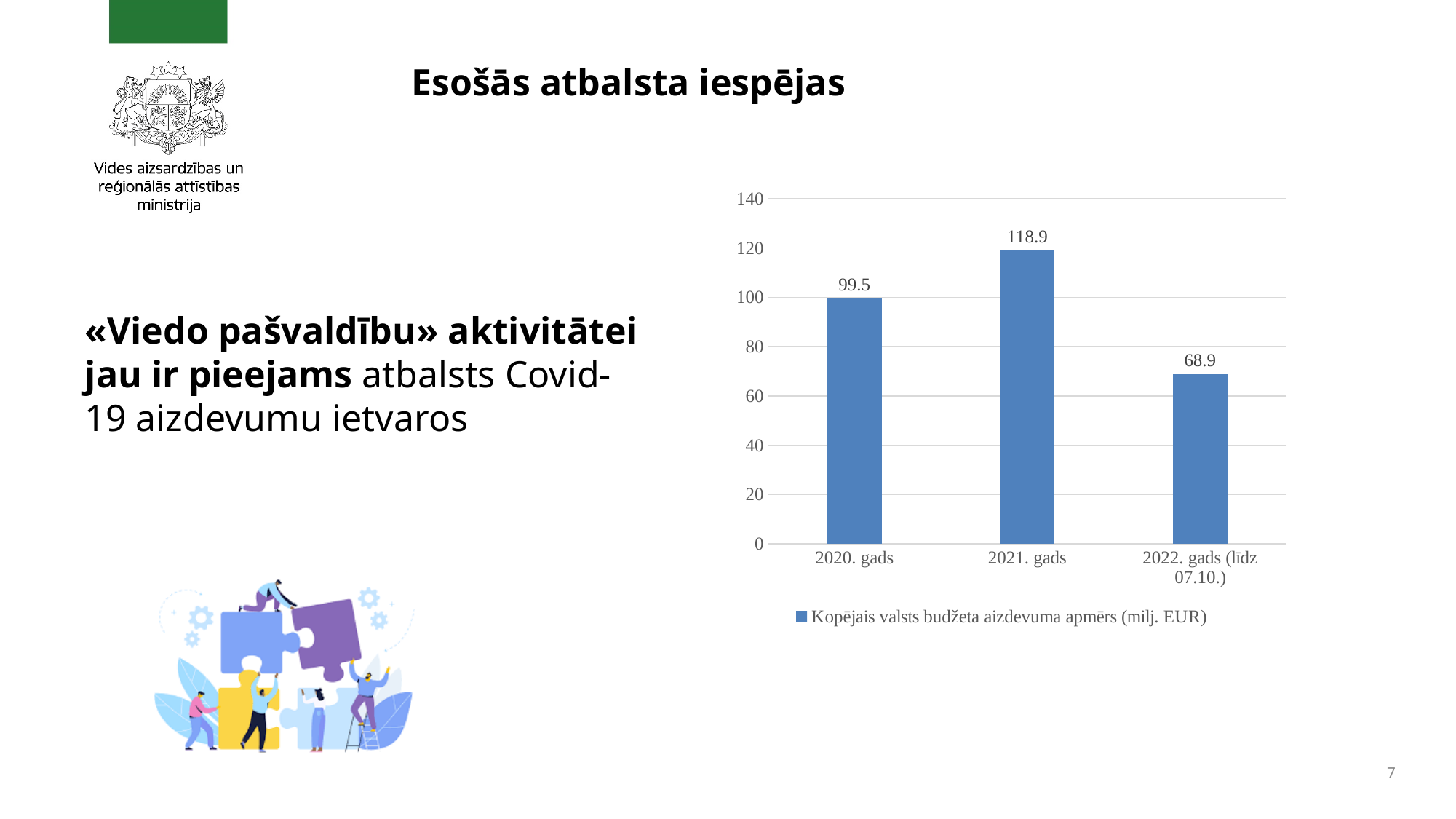
Which category has the lowest value? 2022. gads (līdz 07.10.) Which category has the highest value? 2021. gads What kind of chart is shown on the slide? bar chart What series name does the legend show? Kopējais valsts budžeta aizdevuma apmērs (milj. EUR) What is the value for 2021. gads? 118.9 What is the difference between the values for 2021. gads and 2020. gads? 19.4 Which is larger, the value for 2020. gads or the value for 2022. gads (līdz 07.10.)? 2020. gads What is the value for 2022. gads (līdz 07.10.)? 68.9 What is the value for 2020. gads? 99.5 What is the difference between the values for 2020. gads and 2022. gads (līdz 07.10.)? 30.6 Is the value for 2021. gads greater or less than 100? greater How many categories are shown on the x axis? 3